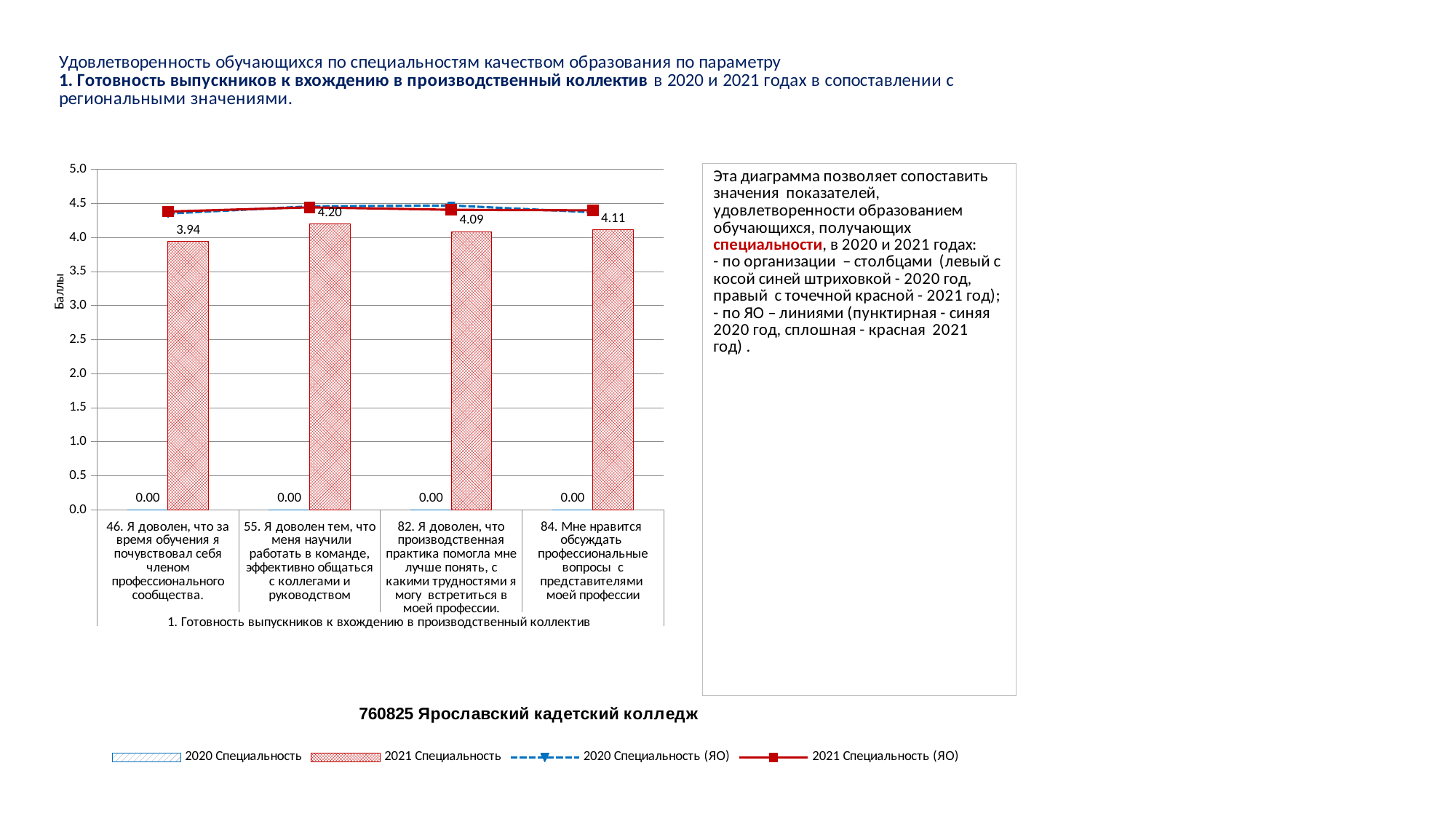
Which question has the lowest 2021 Специальность value? 46. Я доволен, что за время обучения я почувствовал себя членом профессионального сообщества. How many series does the legend list? 4 What is the 2021 Специальность value for question 84 (Мне нравится обсуждать профессиональные вопросы с представителями моей профессии)? 4.11 What is the difference between the 2021 Специальность values for question 55 and question 46? 0.26 What is the label of the vertical axis? Баллы Which question has the highest 2021 Специальность value? 55. Я доволен тем, что меня научили работать в команде, эффективно общаться с коллегами и руководством What is the 2021 Специальность value for question 55 (Я доволен тем, что меня научили работать в команде)? 4.20 Which is larger: the 2021 Специальность value for question 82 or for question 84? question 84 (4.11) What is the 2020 Специальность value for question 82? 0.00 Is the 2021 Специальность (ЯО) line value for question 46 greater or less than 4.0? greater What is the 2021 Специальность value for question 46 (Я доволен, что за время обучения я почувствовал себя членом профессионального сообщества)? 3.94 How many questions (categories) are shown on the x axis? 4